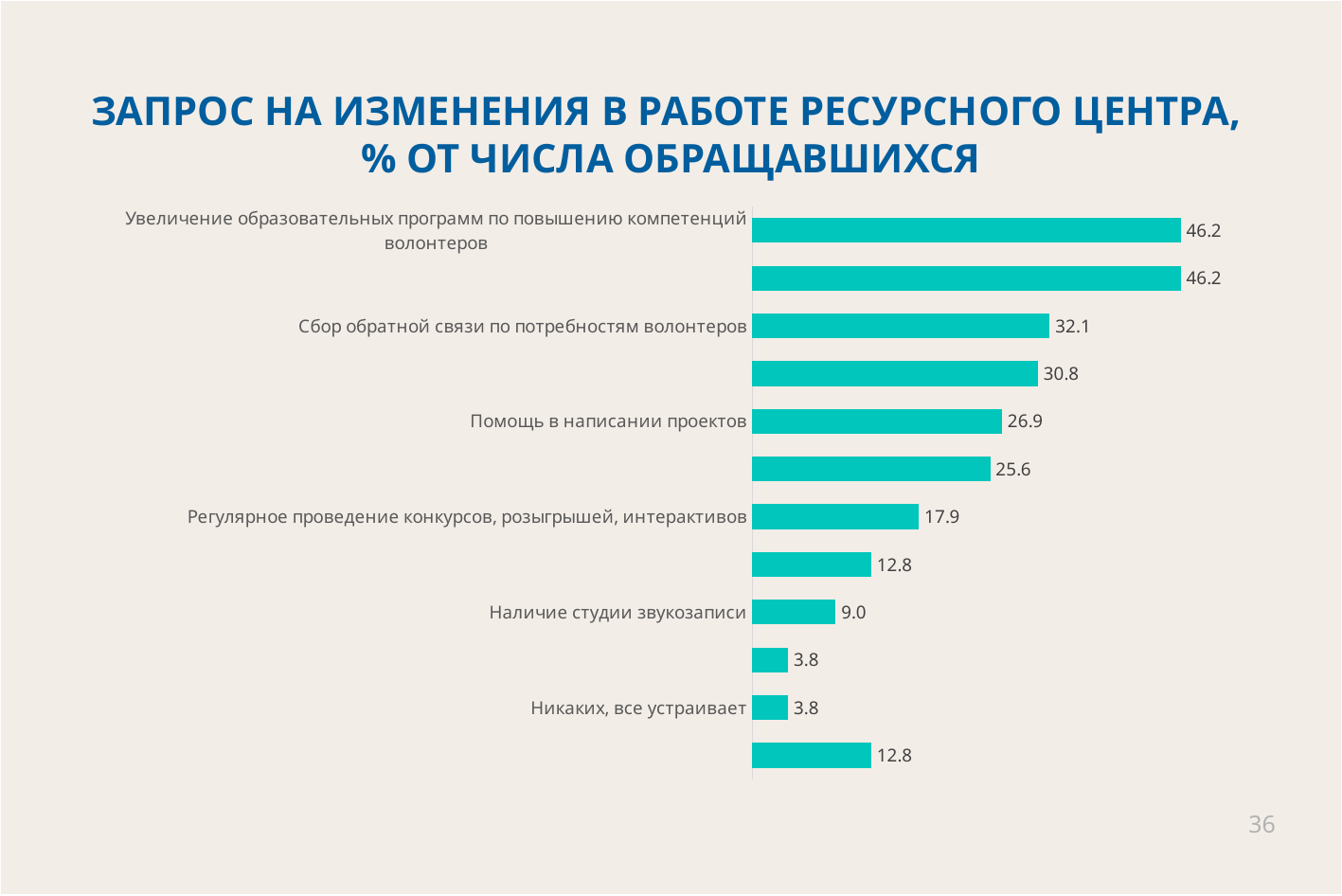
What is the difference between the values for "Увеличение образовательных программ по повышению компетенций волонтеров" and "Сбор обратной связи по потребностям волонтеров"? 14.1 What is the value for "Никаких, все устраивает"? 3.8 What is the value for "Сбор обратной связи по потребностям волонтеров"? 32.1 What is the value for "Помощь в написании проектов"? 26.9 What is the value for "Увеличение образовательных программ по повышению компетенций волонтеров"? 46.2 What is the value for "Регулярное проведение конкурсов, розыгрышей, интерактивов"? 17.9 Which is larger: the value for "Помощь в написании проектов" or the value for "Регулярное проведение конкурсов, розыгрышей, интерактивов"? Помощь в написании проектов How many bars are plotted in the chart? 12 What is the lowest value shown in the chart? 3.8 What type of chart is shown on the slide? bar chart What is the value for "Наличие студии звукозаписи"? 9.0 What is the highest value shown in the chart? 46.2